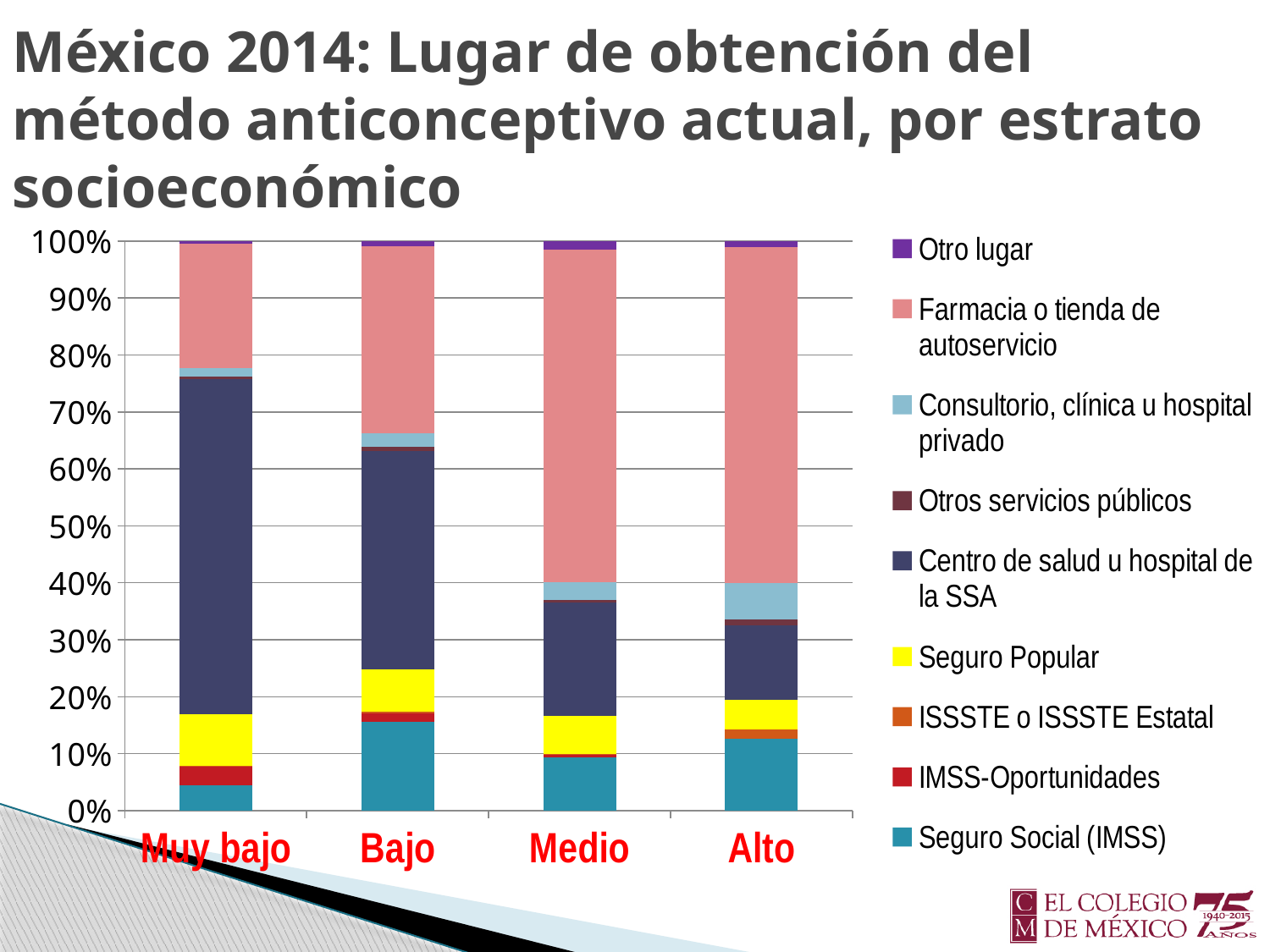
Does the 'Centro de salud u hospital de la SSA' share rise or fall moving from Muy bajo to Alto? Falls Which stratum has the smallest 'Seguro Social (IMSS)' segment? Muy bajo What kind of chart is shown on the slide? Stacked bar chart Is the 'Consultorio, clínica u hospital privado' segment larger for Alto or for Muy bajo? Alto How many series does the legend list? 9 Which series appears at the top of each stacked bar? Otro lugar Which stratum has the smallest 'Farmacia o tienda de autoservicio' segment? Muy bajo Which stratum has the largest 'Centro de salud u hospital de la SSA' segment? Muy bajo Is the 'Seguro Social (IMSS)' share for Bajo greater or less than 10%? greater How many socioeconomic strata (categories) are shown on the x axis? 4 Is the 'Farmacia o tienda de autoservicio' segment larger for Muy bajo or for Alto? Alto Is the 'Centro de salud u hospital de la SSA' share for Muy bajo greater or less than 50%? greater